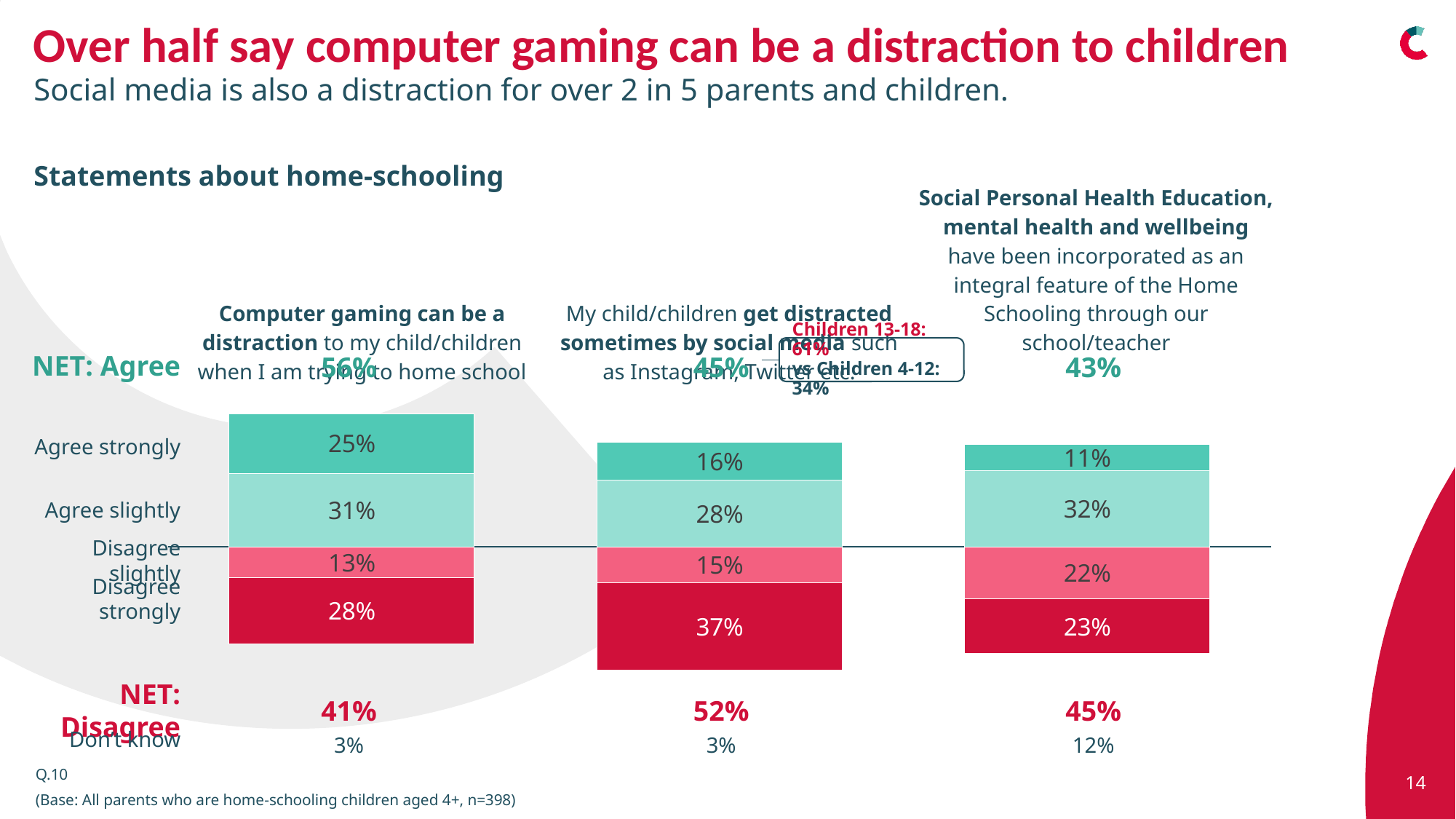
What is the difference between the Disagree strongly percentages for the social media statement and the computer gaming statement? 9 percentage points What percentage of parents agree slightly that Social Personal Health Education, mental health and wellbeing have been incorporated into home schooling? 32% What type of chart is used to show the statements about home-schooling? Stacked bar chart What percentage of parents disagree strongly that their child/children get distracted sometimes by social media? 37% Is the Disagree slightly percentage higher for the social media statement or the Social Personal Health Education statement? Social Personal Health Education statement Which statement has the highest NET: Agree percentage? Computer gaming can be a distraction to my child/children when I am trying to home school How many statements about home-schooling are shown in the chart? 3 Which statement has the lowest Agree strongly percentage? Social Personal Health Education, mental health and wellbeing have been incorporated as an integral feature of the Home Schooling What percentage of parents agree strongly that computer gaming can be a distraction to their child/children when home schooling? 25% What is the NET: Disagree figure for the statement about children getting distracted by social media? 52% What is the Don't know percentage for the statement about Social Personal Health Education being incorporated into home schooling? 12% What is the NET: Agree figure for the statement that computer gaming can be a distraction? 56%